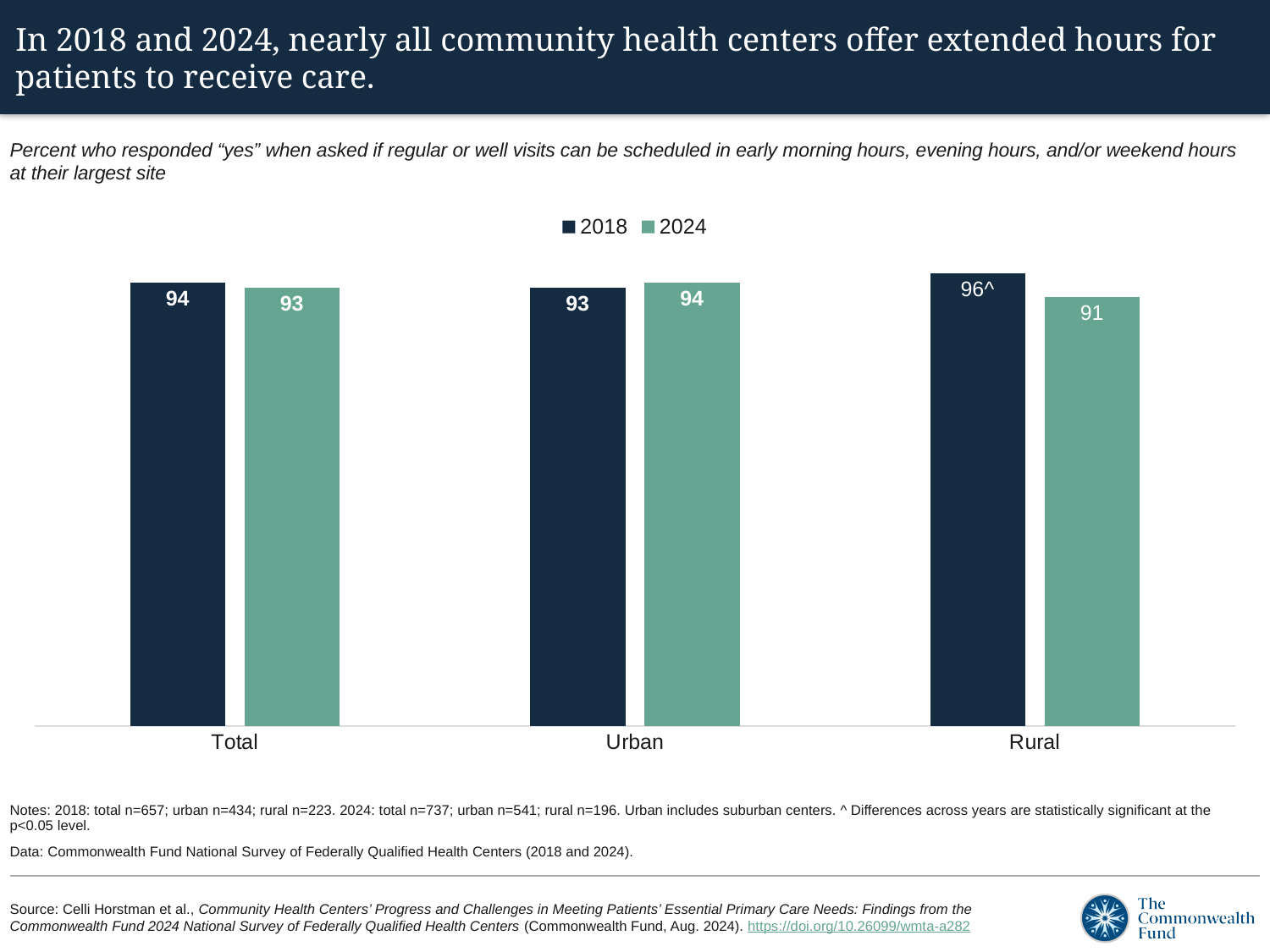
What is the value for Urban in 2024? 94 Which category has the highest value in the 2018 series? Rural What is the value for Rural in 2024? 91 Which is larger for Urban: the 2018 value or the 2024 value? 2024 Which category has the lowest value in the 2024 series? Rural What is the value for Rural in 2018? 96^ How many categories are shown on the x axis? 3 What kind of chart is shown on the slide? Bar chart How many series does the legend list? 2 Which series is shown in the dark navy colour? 2018 What is the difference between the 2018 and 2024 values for Rural? 5 What is the value for Total in 2018? 94